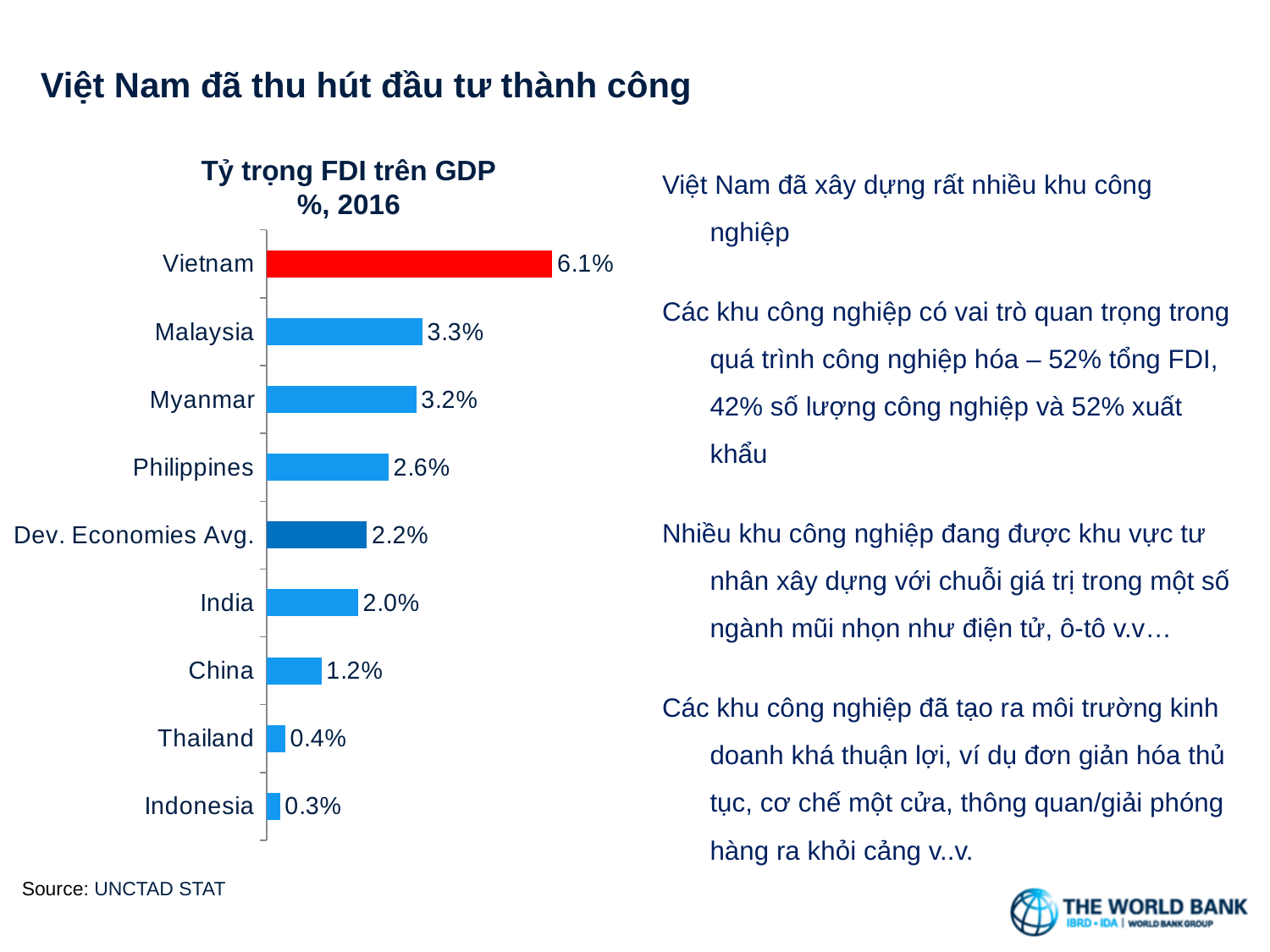
How many categories are shown in the chart? 9 What is the difference between the Philippines' and China's FDI share of GDP? 1.4% Which country has the highest FDI share of GDP? Vietnam What is the difference between Vietnam's and Malaysia's FDI share of GDP? 2.8% Which country has the lowest FDI share of GDP? Indonesia What is the FDI share of GDP for Vietnam? 6.1% Which has a higher FDI share of GDP, India or China? India What is the FDI share of GDP for Thailand? 0.4% What is the FDI share of GDP for Malaysia? 3.3% What is the value shown for Dev. Economies Avg.? 2.2% What type of chart is shown on the slide? Bar chart What is the title of the chart? Tỷ trọng FDI trên GDP %, 2016